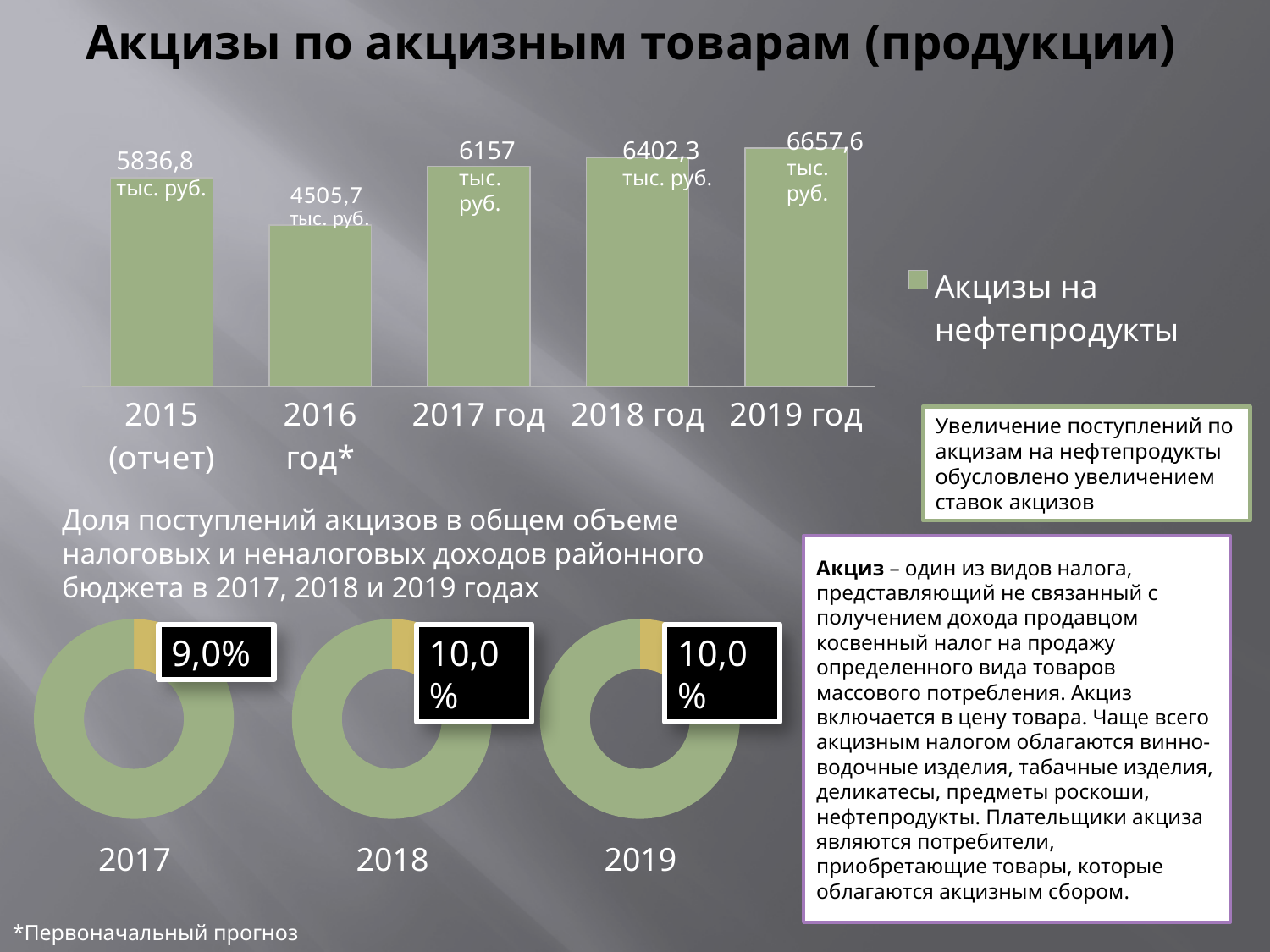
На столбчатой диаграмме на сколько значение 2019 года больше значения 2018 года? 255,3 тыс. руб. Сколько столбцов (категорий) показано на столбчатой диаграмме? 5 Сколько рядов данных указано в легенде столбчатой диаграммы? 1 На столбчатой диаграмме какое значение указано для 2019 год? 6657,6 тыс. руб. Какой тип диаграммы используется в верхней части слайда? Столбчатая диаграмма На столбчатой диаграмме какое значение указано для 2018 год? 6402,3 тыс. руб. На столбчатой диаграмме в каком году значение акцизов на нефтепродукты наибольшее? 2019 год Как называется ряд данных в легенде столбчатой диаграммы? Акцизы на нефтепродукты На столбчатой диаграмме «Акцизы на нефтепродукты» какое значение указано для 2015 (отчет)? 5836,8 тыс. руб. На кольцевой диаграмме за 2017 год какая доля поступлений акцизов указана? 9,0% На столбчатой диаграмме какое значение больше: за 2015 (отчет) или за 2016 год*? 2015 (отчет) На столбчатой диаграмме в каком году значение акцизов на нефтепродукты наименьшее? 2016 год*